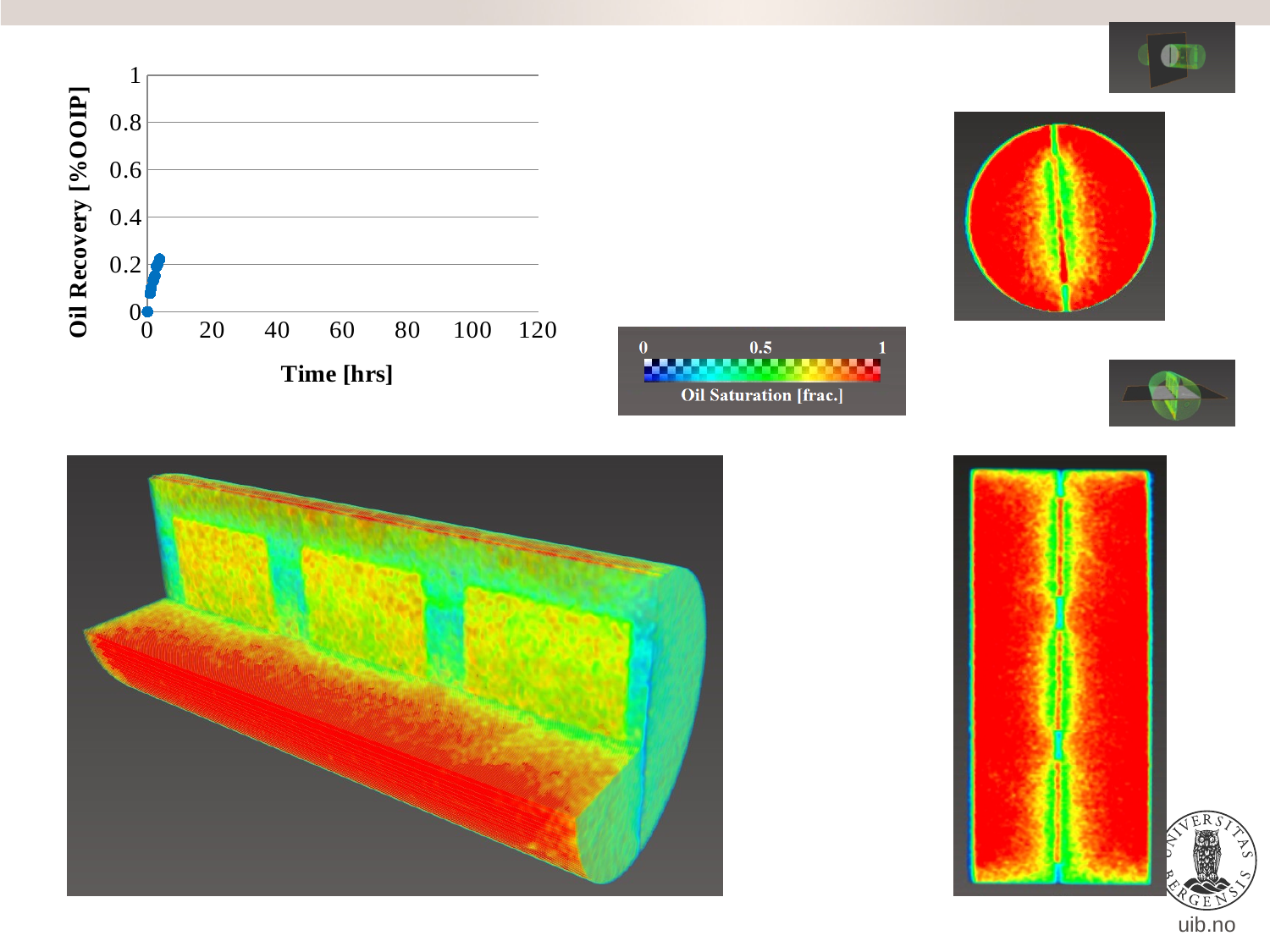
What is the title of the vertical axis of the chart? Oil Recovery [%OOIP] What is the title of the horizontal axis of the chart? Time [hrs] Is the time of the latest plotted point greater or less than 20 hrs? less Is the highest plotted oil recovery value greater or less than 0.4? less Is the lowest plotted oil recovery value greater or less than 0.2? less Do the oil recovery values rise or fall as time increases along the x axis? rise What kind of chart is shown on the slide? scatter chart